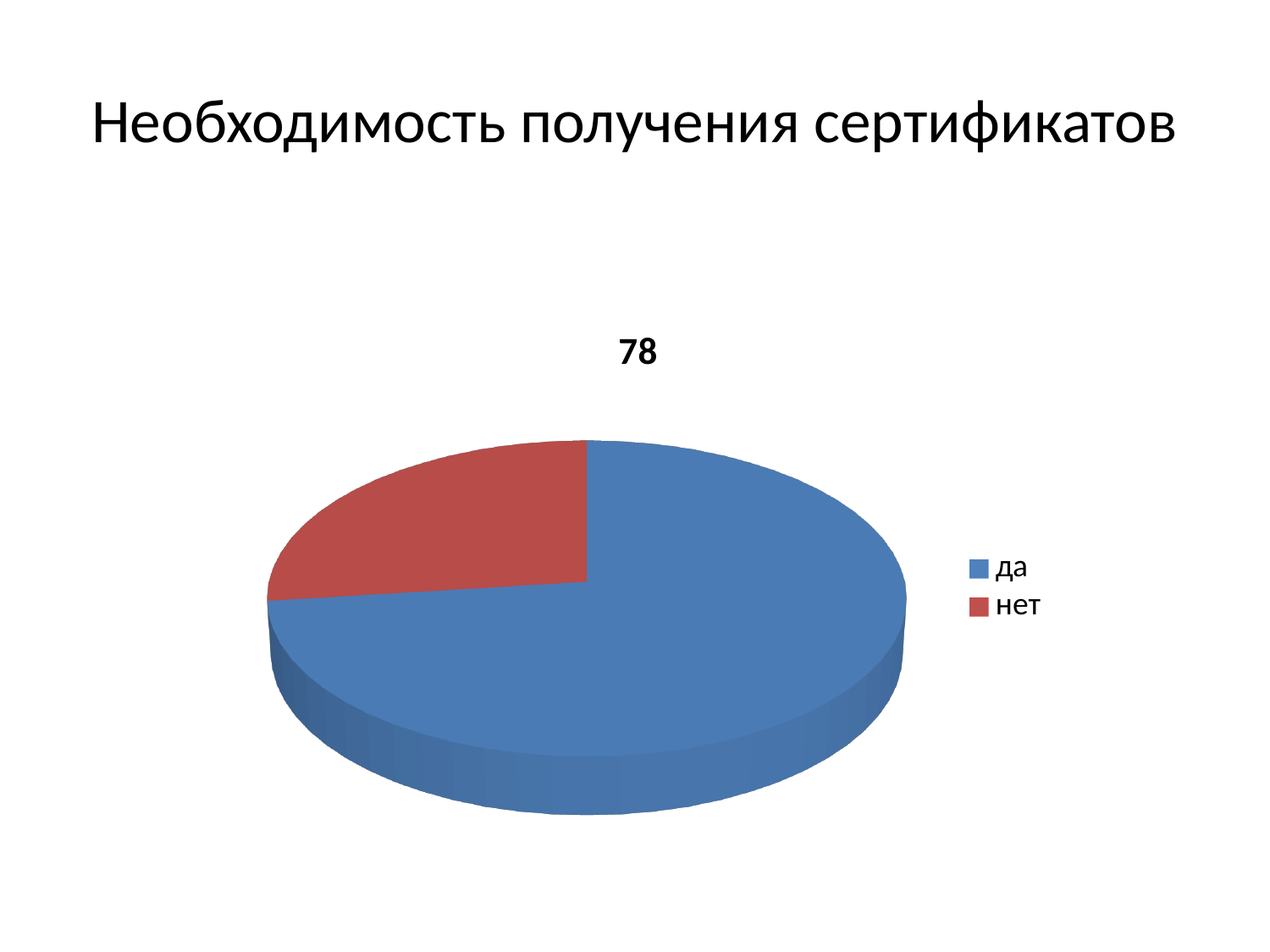
Which slice is larger in the pie chart, да or нет? да How many slices does the pie chart have? 2 How many entries does the legend of the pie chart list? 2 Which category has the smallest slice in the pie chart? нет Which category has the largest slice in the pie chart? да What is the title shown above the pie chart? 78 What colour is the slice for нет in the pie chart? red What kind of chart is shown on the slide? pie chart